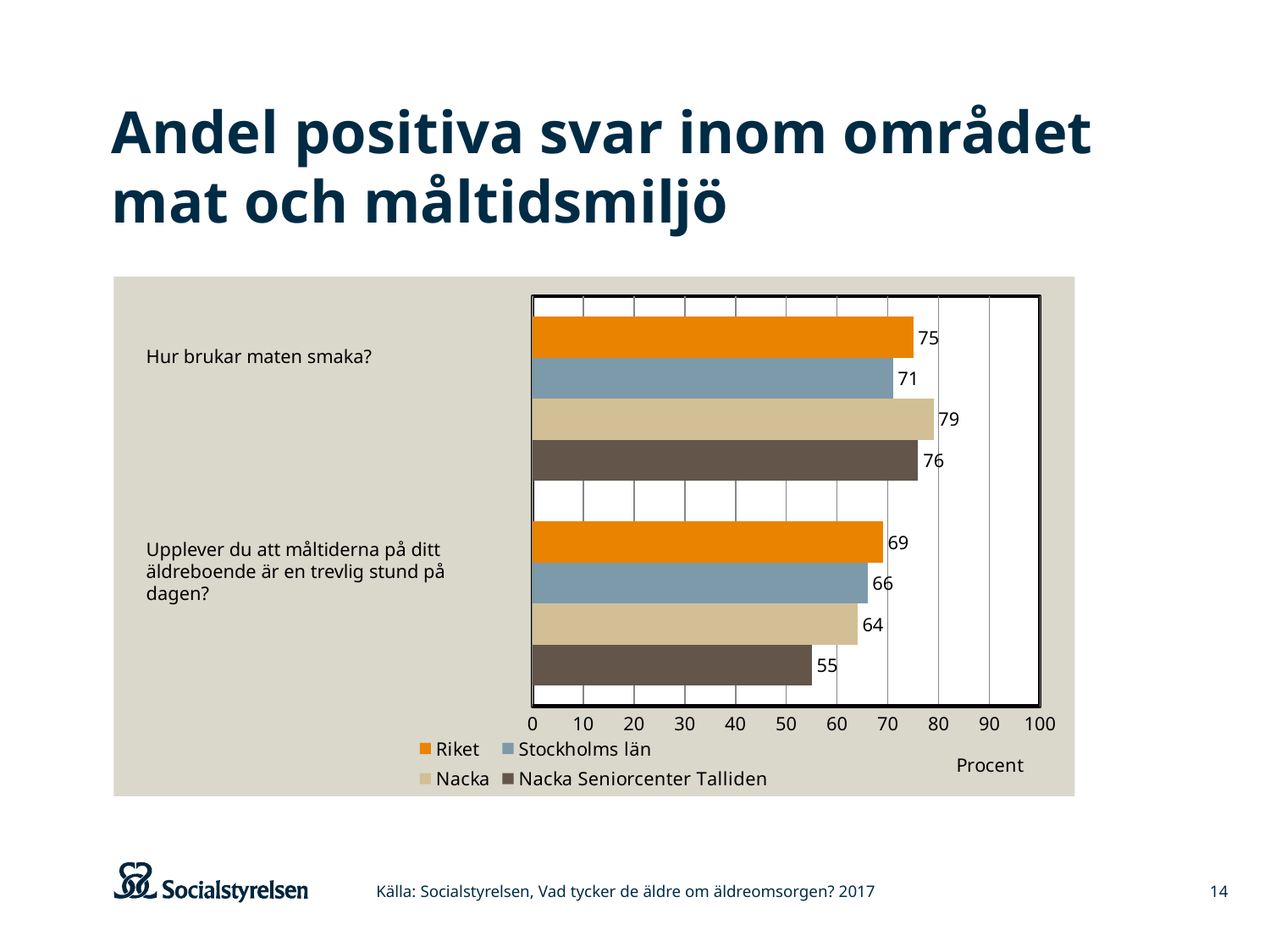
What is the value for Stockholms län for the question "Upplever du att måltiderna på ditt äldreboende är en trevlig stund på dagen?"? 66 What is the value for Nacka Seniorcenter Talliden for the question "Upplever du att måltiderna på ditt äldreboende är en trevlig stund på dagen?"? 55 What is the difference between the Nacka value and the Stockholms län value for the question "Hur brukar maten smaka?"? 8 Which series has the highest value for the question "Hur brukar maten smaka?"? Nacka Which series has the lowest value for the question "Upplever du att måltiderna på ditt äldreboende är en trevlig stund på dagen?"? Nacka Seniorcenter Talliden What kind of chart is shown on the slide? Bar chart What is the value for Riket for the question "Hur brukar maten smaka?"? 75 What is the label of the horizontal axis? Procent What is the value for Nacka for the question "Hur brukar maten smaka?"? 79 Which is larger for the question "Hur brukar maten smaka?": the value for Riket or the value for Nacka Seniorcenter Talliden? Nacka Seniorcenter Talliden How many series does the legend list? 4 What is the difference between the Riket value and the Nacka Seniorcenter Talliden value for the question "Upplever du att måltiderna på ditt äldreboende är en trevlig stund på dagen?"? 14